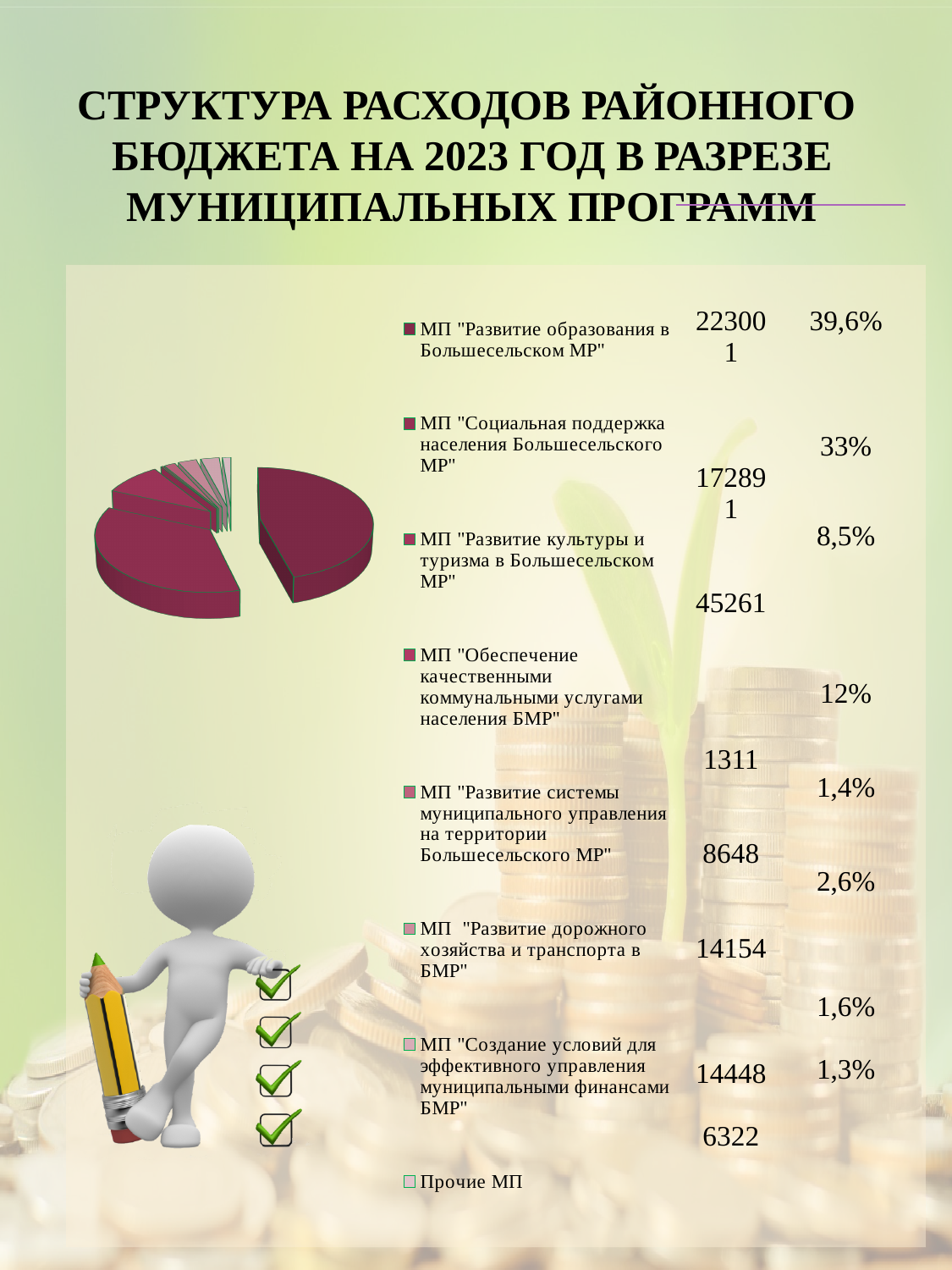
How many entries does the legend of the pie chart list? 8 What is the title of the slide containing the pie chart? СТРУКТУРА РАСХОДОВ РАЙОННОГО БЮДЖЕТА НА 2023 ГОД В РАЗРЕЗЕ МУНИЦИПАЛЬНЫХ ПРОГРАММ What kind of chart is shown on the slide? Pie chart Which municipal programme has the largest share of the 2023 district budget expenditure? МП "Развитие образования в Большесельском МР" Which has the larger share: МП "Социальная поддержка населения Большесельского МР" or МП "Развитие культуры и туризма в Большесельском МР"? МП "Социальная поддержка населения Большесельского МР"